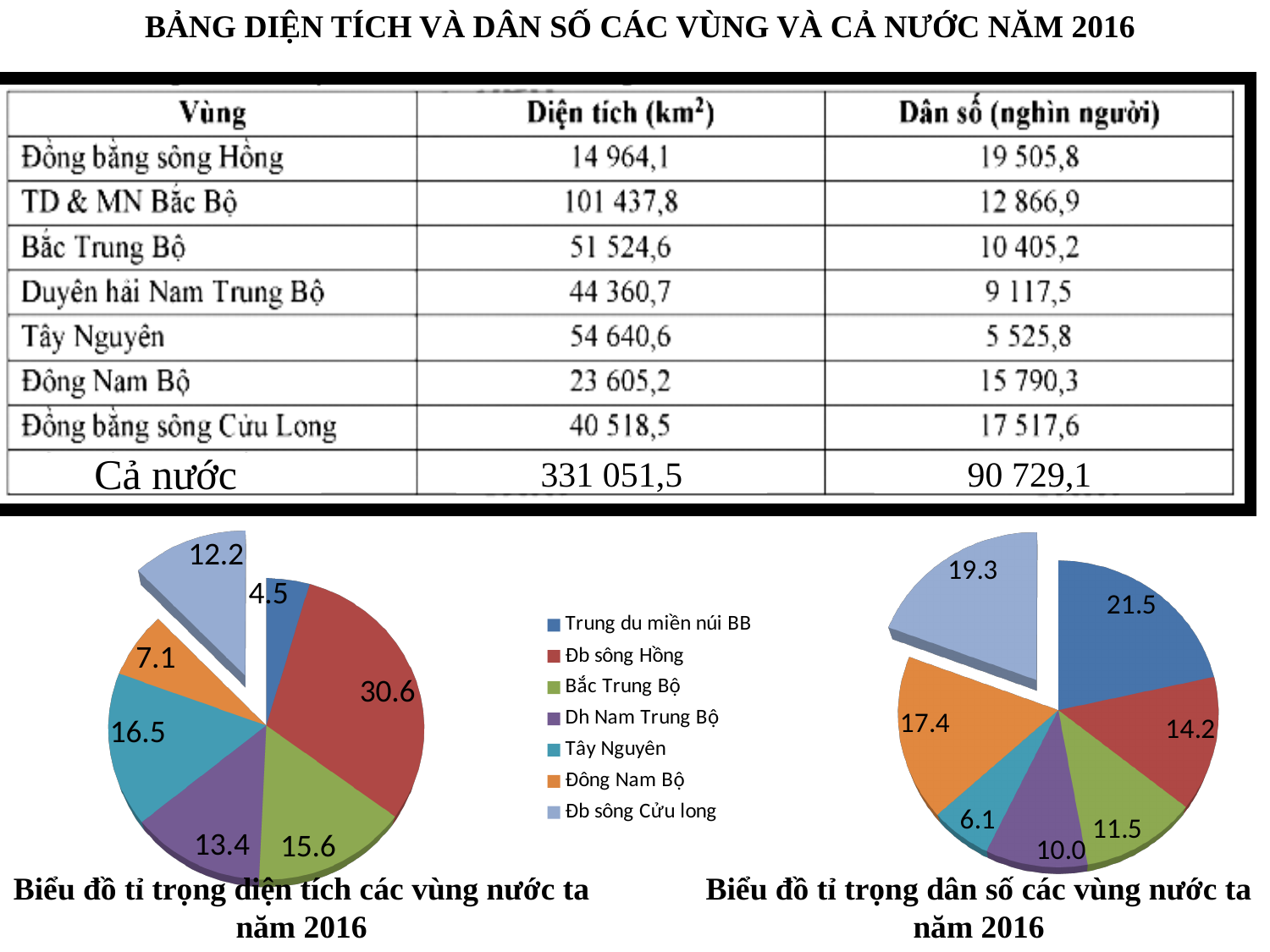
In the left chart (tỉ trọng diện tích), what is the share for Tây Nguyên? 16.5 In the right chart (tỉ trọng dân số), what is the share for Bắc Trung Bộ? 11.5 In the right chart (tỉ trọng dân số), what is the difference between the shares for Đb sông Cửu long and Đông Nam Bộ? 1.9 In the left chart (tỉ trọng diện tích), which is larger: the share for Bắc Trung Bộ or for Dh Nam Trung Bộ? Bắc Trung Bộ In the left chart (tỉ trọng diện tích), what is the share for Đông Nam Bộ? 7.1 How many regions does the shared legend between the two pie charts list? 7 How many slices does the right chart (tỉ trọng dân số) have? 7 In the left chart (tỉ trọng diện tích), what is the share for Đb sông Cửu long? 12.2 In the left chart (tỉ trọng diện tích), what is the largest share value shown? 30.6 What kind of chart is the left chart, 'Biểu đồ tỉ trọng diện tích các vùng nước ta năm 2016'? Pie chart In the right chart (tỉ trọng dân số), what is the share for Đông Nam Bộ? 17.4 In the right chart (tỉ trọng dân số), which region has the smallest share? Tây Nguyên